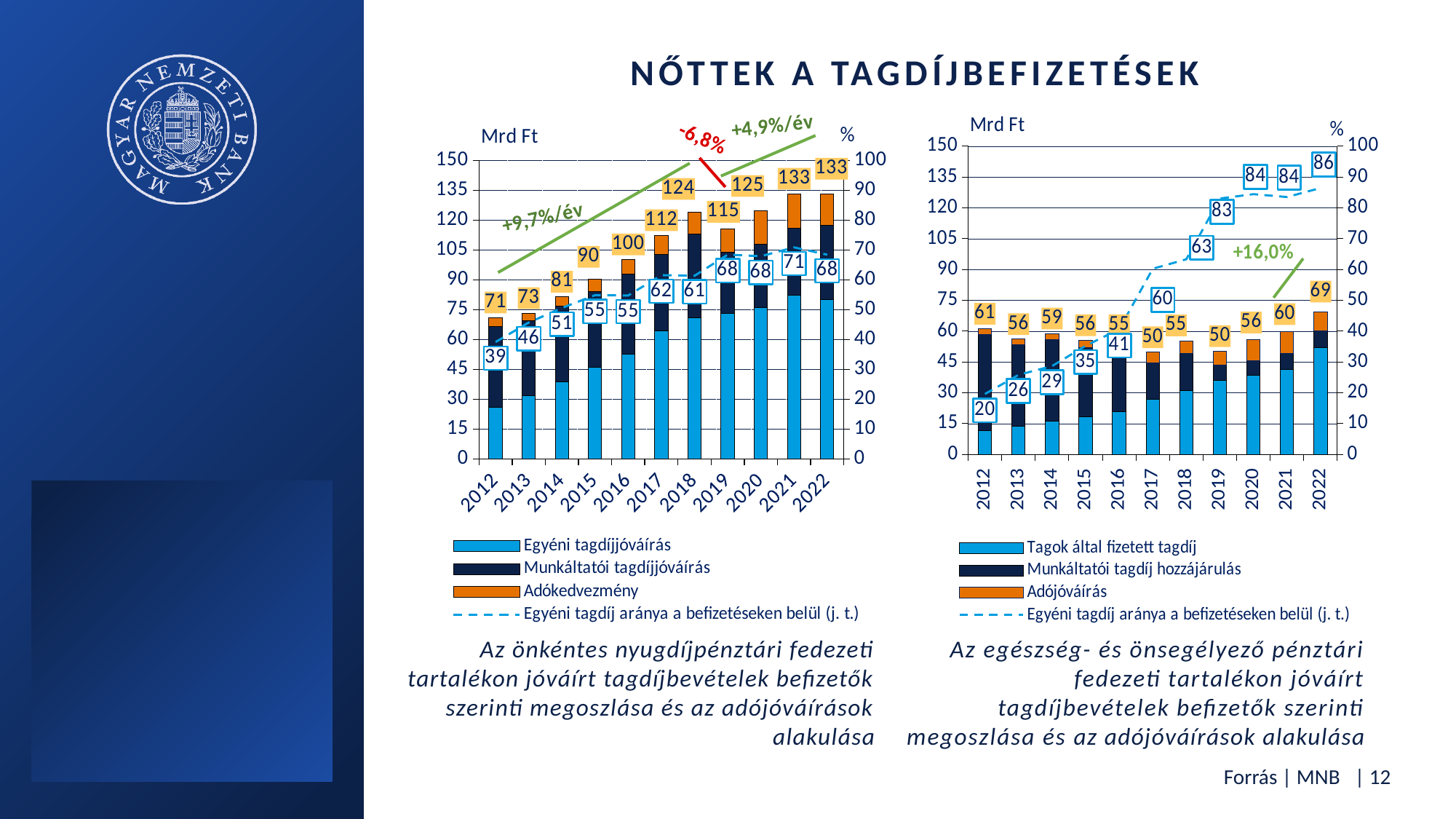
In the right chart, what is the total labelled on the stacked bar for 2022? 69 In the left chart, what is the difference between the bar totals for 2022 and 2012? 62 What type of chart is the left chart? Stacked bar chart with a line In the left chart, what is the total labelled on the stacked bar for 2018? 124 In the left chart, what value does the dashed line (Egyéni tagdíj aránya a befizetéseken belül) show for 2012? 39 In the right chart, what is the difference between the dashed-line values for 2022 and 2012? 66 In the left chart, which year has the lowest labelled bar total? 2012 How many series does the legend of the left chart list? 4 In the right chart, what value does the dashed line show for 2019? 83 In the right chart, which year has the highest labelled bar total? 2022 How many years are shown on the x axis of the right chart? 11 In the left chart, is the bar total for 2019 larger or smaller than the bar total for 2018? smaller